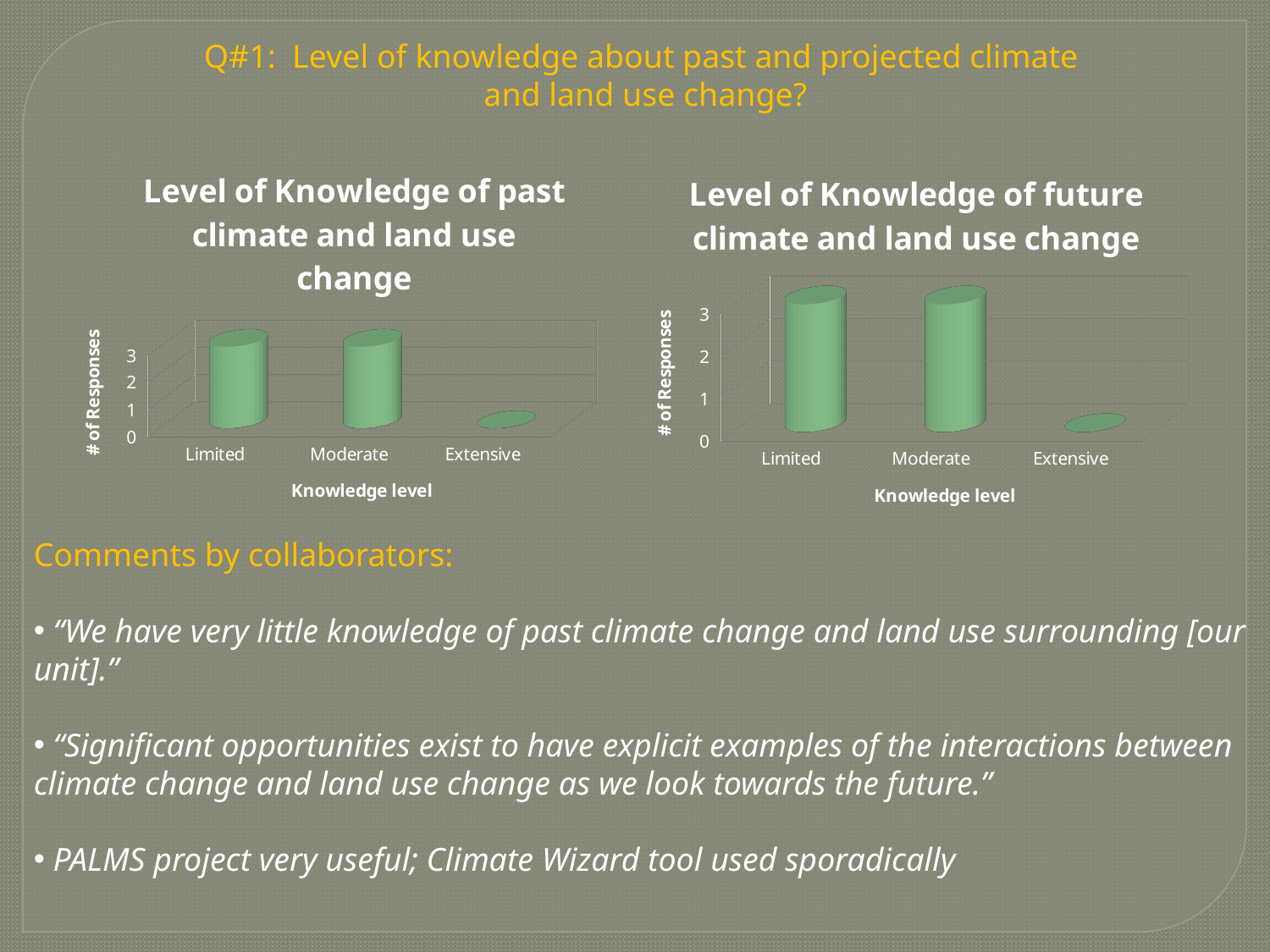
On the 'Level of Knowledge of past climate and land use change' chart, which has more responses, Moderate or Extensive? Moderate How many charts are shown on the slide? 2 On the 'Level of Knowledge of past climate and land use change' chart, which knowledge level has the lowest number of responses? Extensive What kind of chart is the 'Level of Knowledge of past climate and land use change' chart? bar chart What is the y-axis title of the 'Level of Knowledge of future climate and land use change' chart? # of Responses How many knowledge level categories are shown on the 'Level of Knowledge of future climate and land use change' chart? 3 On the 'Level of Knowledge of future climate and land use change' chart, is the number of responses for Moderate greater or less than 2? greater On the 'Level of Knowledge of past climate and land use change' chart, is the number of responses for Limited greater or less than 2? greater What is the x-axis title of the 'Level of Knowledge of past climate and land use change' chart? Knowledge level On the 'Level of Knowledge of future climate and land use change' chart, which has more responses, Limited or Extensive? Limited On the 'Level of Knowledge of past climate and land use change' chart, is the number of responses for Extensive greater or less than 1? less On the 'Level of Knowledge of future climate and land use change' chart, which knowledge level has the lowest number of responses? Extensive